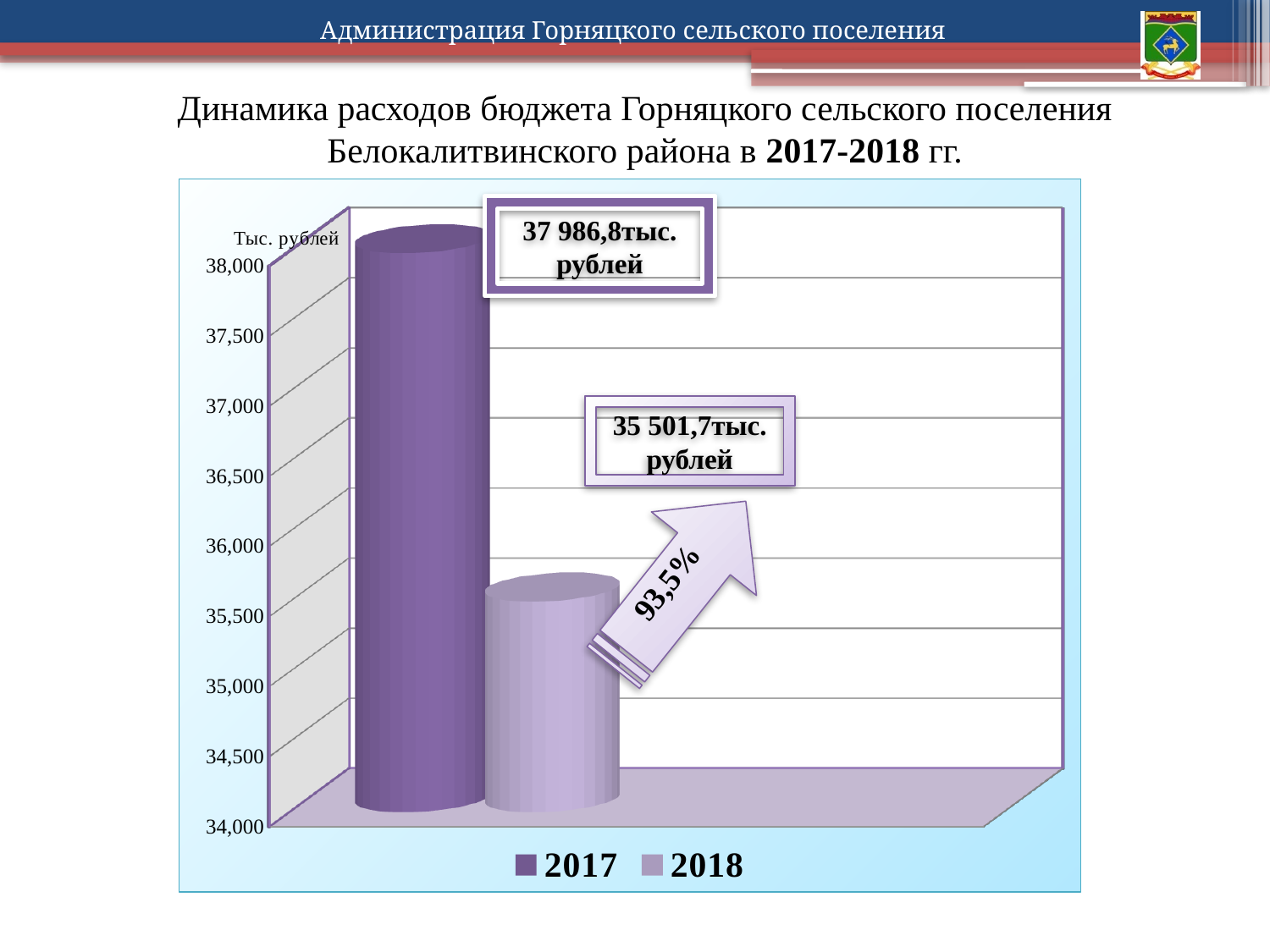
What kind of chart is shown on the slide? bar chart What is the budget expenditure value shown for 2018? 35 501,7 тыс. рублей Is the value for 2018 greater or less than 36,000? less How many bars are plotted on the chart? 2 Which year has the higher budget expenditure? 2017 What percentage is written on the arrow between the two bars? 93,5% Is the value for 2017 greater or less than 37,500? greater How many entries does the legend list? 2 What is the budget expenditure value shown for 2017? 37 986,8 тыс. рублей By how much do the 2017 expenditures exceed the 2018 expenditures? 2 485,1 тыс. рублей Is the value for 2018 larger or smaller than the value for 2017? smaller Which year has the lower budget expenditure? 2018